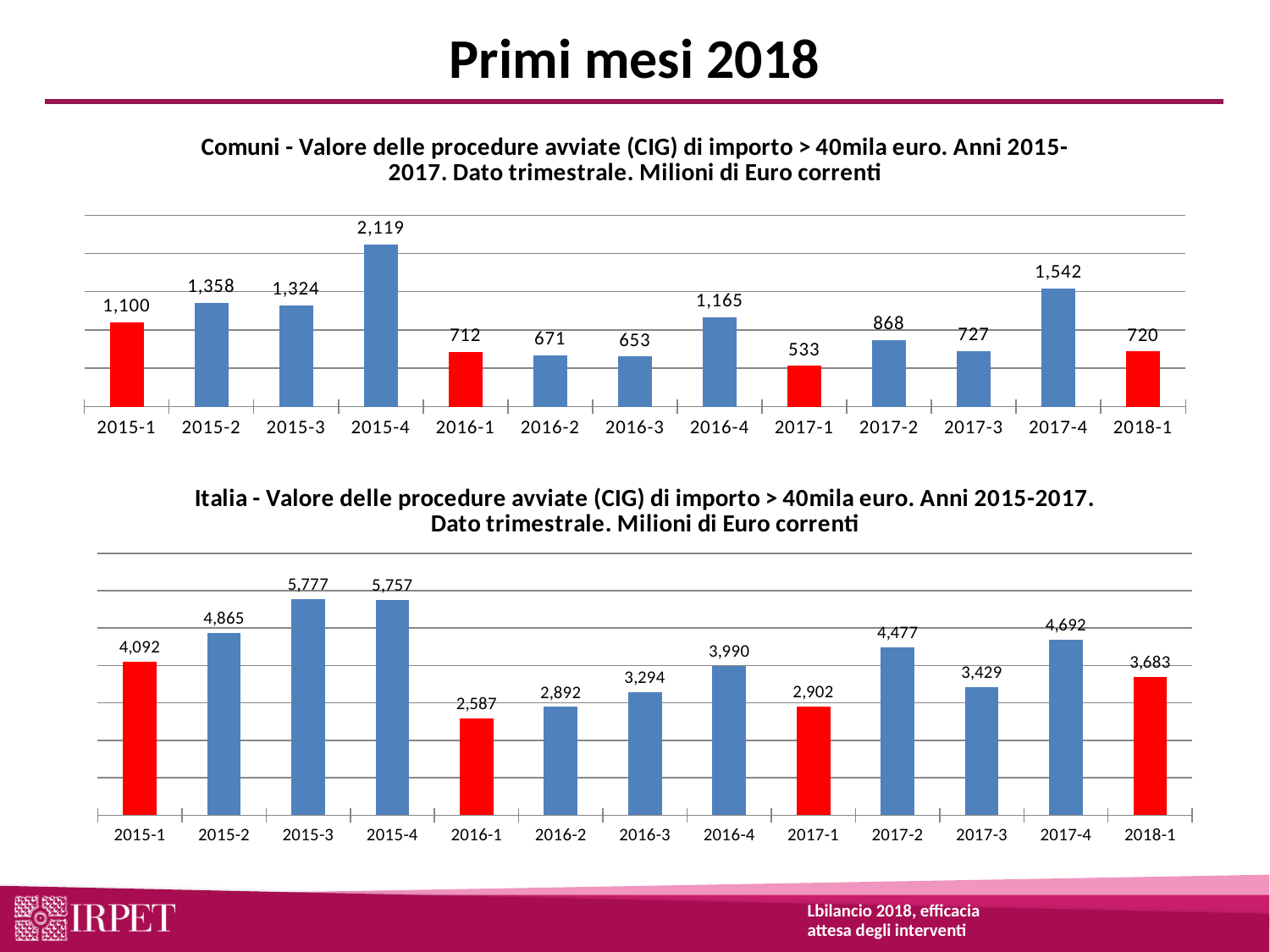
In the Italia chart (bottom), which is larger, the value for 2016-3 or the value for 2017-3? 2017-3 In the Comuni chart (top), what is the value for 2015-4? 2,119 In the Comuni chart (top), which is larger, the value for 2016-4 or the value for 2017-2? 2016-4 In the Italia chart (bottom), what is the value for 2016-1? 2,587 How many quarters are shown on the x axis of the Comuni chart (top)? 13 What kind of chart is the Italia chart (bottom)? Bar chart In the Italia chart (bottom), what colour are the bars for the first quarter of each year (2015-1, 2016-1, 2017-1, 2018-1)? Red In the Comuni chart (top), what is the value for 2018-1? 720 In the Comuni chart (top), what is the difference between the values for 2015-4 and 2017-1? 1,586 In the Comuni chart (top), which quarter has the lowest value? 2017-1 In the Italia chart (bottom), which quarter has the highest value? 2015-3 In the Italia chart (bottom), what is the difference between the values for 2017-4 and 2018-1? 1,009